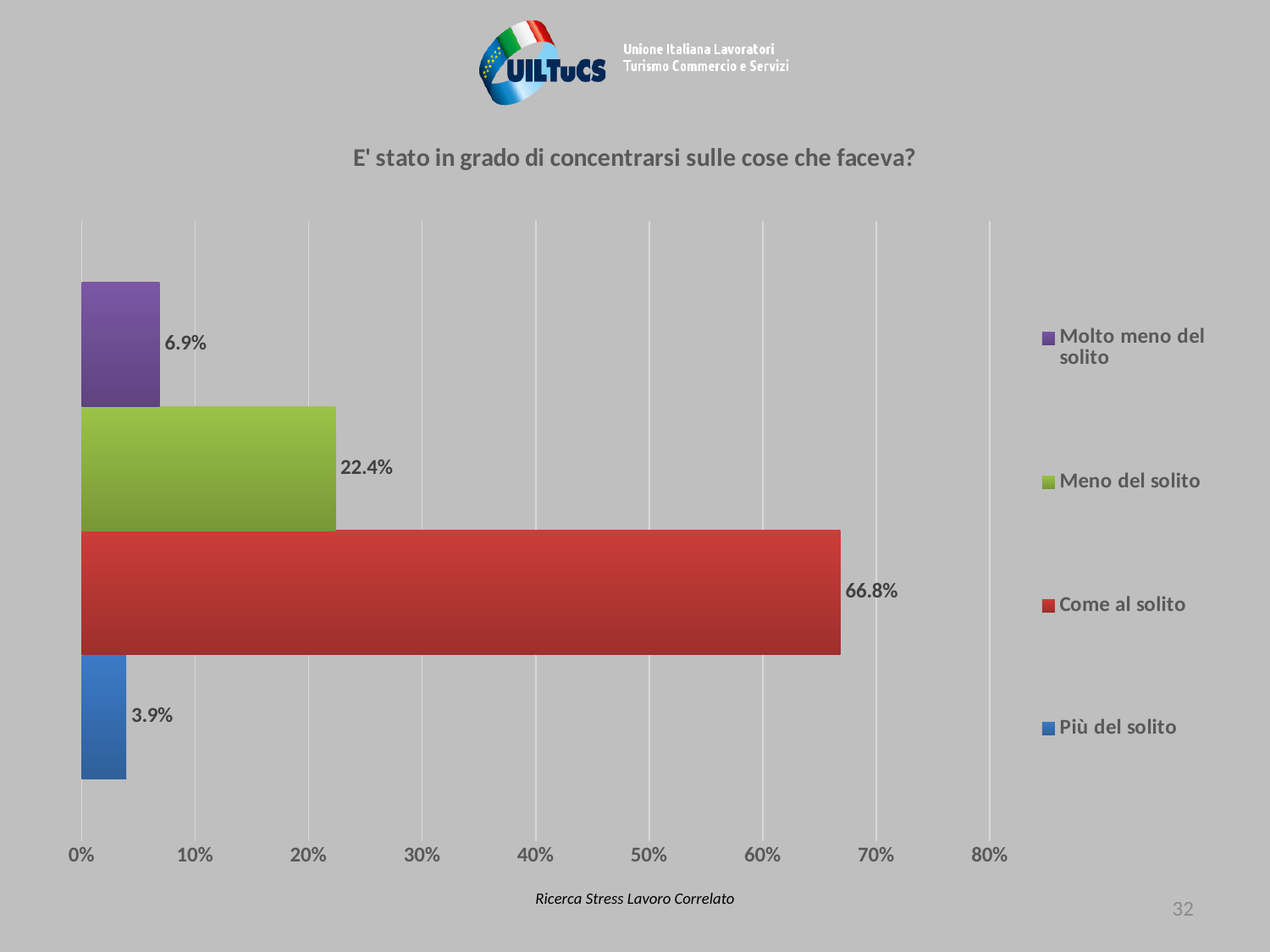
What kind of chart is shown on the slide? bar chart What is the value for "Più del solito"? 3.9% What is the value for "Meno del solito"? 22.4% Is the value for "Come al solito" greater or less than 60%? greater What is the difference between the values for "Come al solito" and "Meno del solito"? 44.4% How many categories are shown in the chart? 4 What is the value for "Molto meno del solito"? 6.9% Which category has the lowest value? Più del solito Which is larger, the value for "Molto meno del solito" or the value for "Più del solito"? Molto meno del solito What is the value for "Come al solito"? 66.8% What is the title of the chart? E' stato in grado di concentrarsi sulle cose che faceva? Which category has the highest value? Come al solito